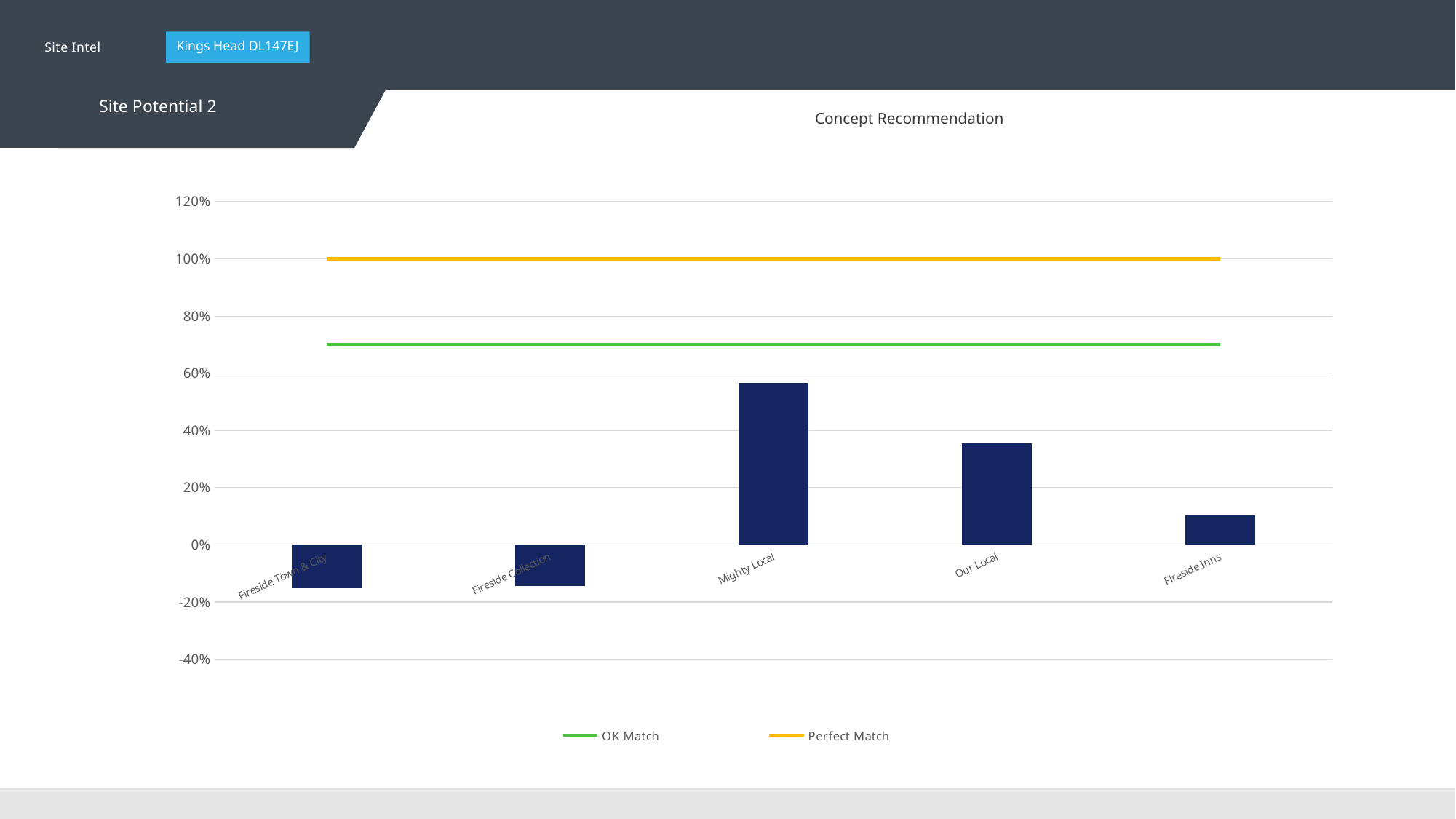
Which is larger, the value for Mighty Local or the value for Our Local? Mighty Local Is the value for Mighty Local greater or less than 40%? greater Is the OK Match line greater or less than 80%? less How many entries does the chart legend list? 2 At what level on the y axis does the Perfect Match line sit? 100% How many categories are shown on the x axis of the chart? 5 Which category has the highest bar in the chart? Mighty Local Is the value for Fireside Collection greater or less than 0%? less What is the title of the chart? Concept Recommendation What kind of chart is shown on the slide? combination bar and line chart